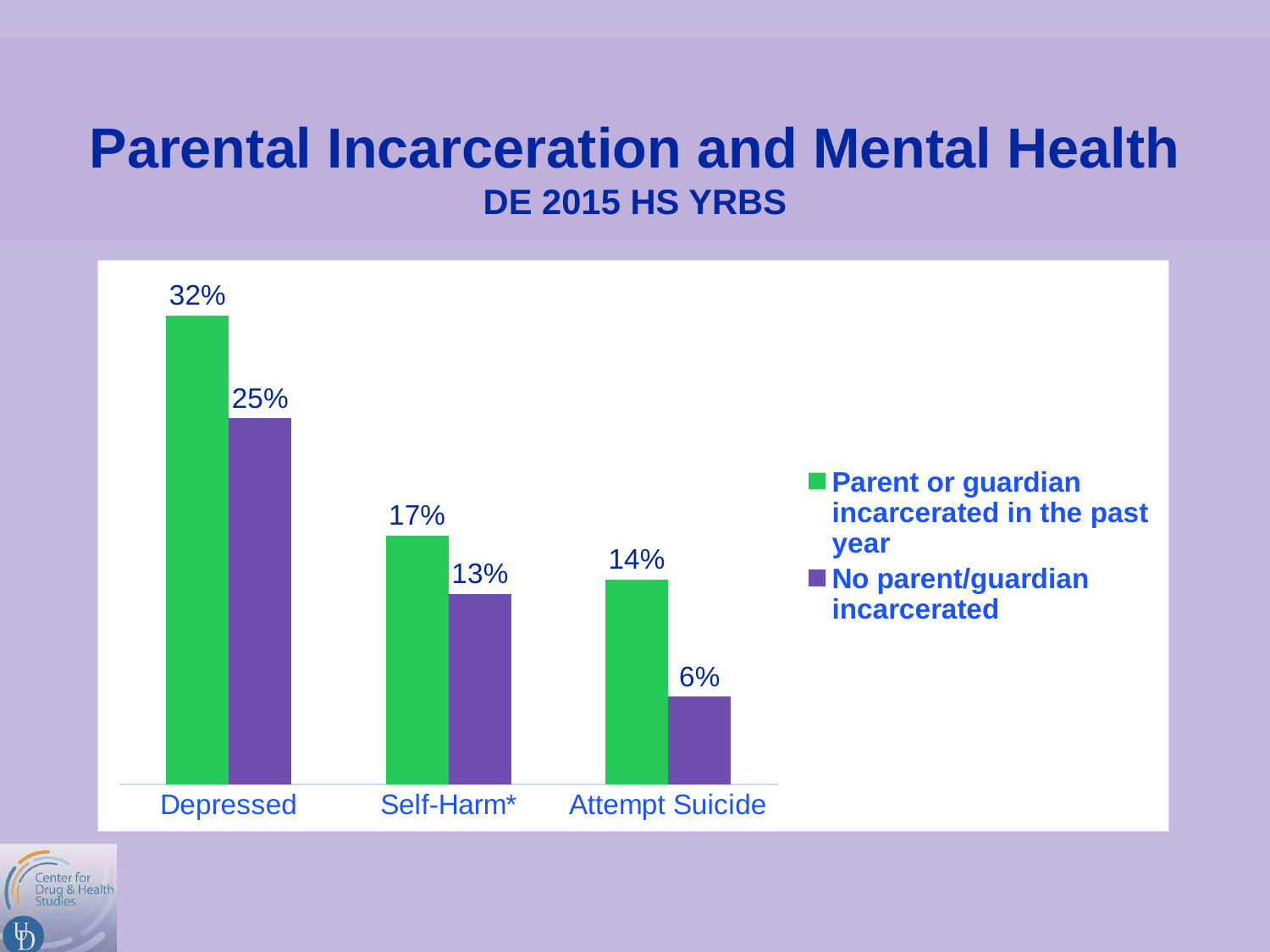
What is the value for Attempt Suicide among students with no parent/guardian incarcerated? 6% What is the difference between the two series for the Depressed category? 7% What is the difference between the two series for Attempt Suicide? 8% For Self-Harm*, which series has the larger value? Parent or guardian incarcerated in the past year How many categories are shown on the x axis? 3 How many series does the legend list? 2 What is the Self-Harm* value for the 'No parent/guardian incarcerated' series? 13% What percentage of students with a parent or guardian incarcerated in the past year reported being depressed? 32% Which colour represents the 'No parent/guardian incarcerated' series? Purple Which category has the highest value for the 'Parent or guardian incarcerated in the past year' series? Depressed What kind of chart is shown on the slide? Bar chart Which category has the lowest value for the 'No parent/guardian incarcerated' series? Attempt Suicide